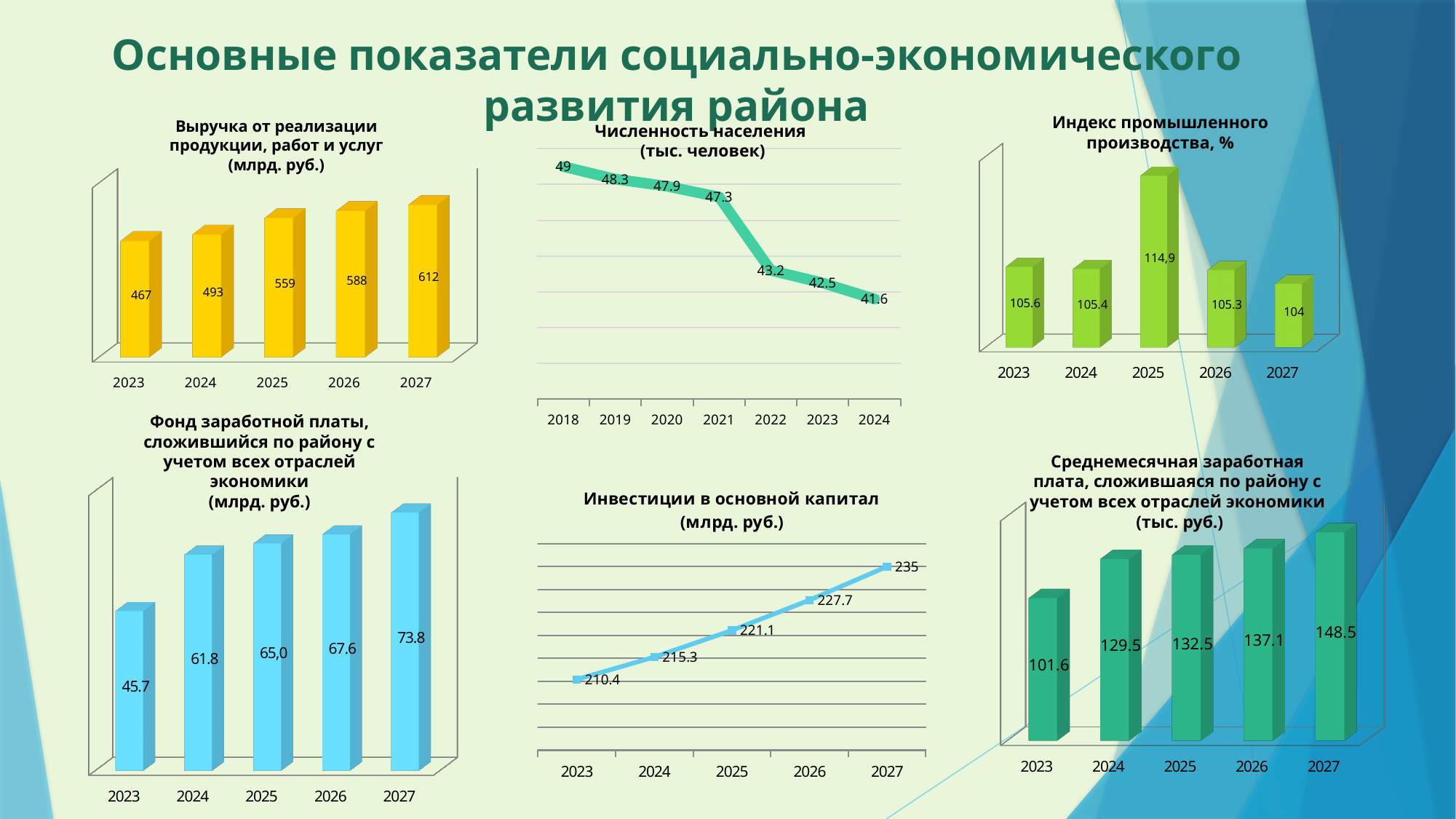
In the chart 'Фонд заработной платы, сложившийся по району с учетом всех отраслей экономики (млрд. руб.)', which year has the lowest value? 2023 In the chart 'Численность населения (тыс. человек)', do the values rise or fall from 2018 to 2024? fall In the chart 'Выручка от реализации продукции, работ и услуг (млрд. руб.)', what is the value for 2025? 559 In the chart 'Индекс промышленного производства, %', which year has the highest value? 2025 In the chart 'Индекс промышленного производства, %', what is the value for 2027? 104 In the chart 'Выручка от реализации продукции, работ и услуг (млрд. руб.)', what is the difference between the values for 2027 and 2023? 145 In the chart 'Инвестиции в основной капитал (млрд. руб.)', what is the value for 2024? 215.3 What kind of chart is 'Инвестиции в основной капитал (млрд. руб.)'? line chart In the chart 'Численность населения (тыс. человек)', what is the value for 2021? 47.3 In the chart 'Среднемесячная заработная плата, сложившаяся по району с учетом всех отраслей экономики (тыс. руб.)', which is larger, the value for 2024 or the value for 2023? 2024 How many data points are plotted in the chart 'Численность населения (тыс. человек)'? 7 In the chart 'Фонд заработной платы, сложившийся по району с учетом всех отраслей экономики (млрд. руб.)', what is the value for 2026? 67.6